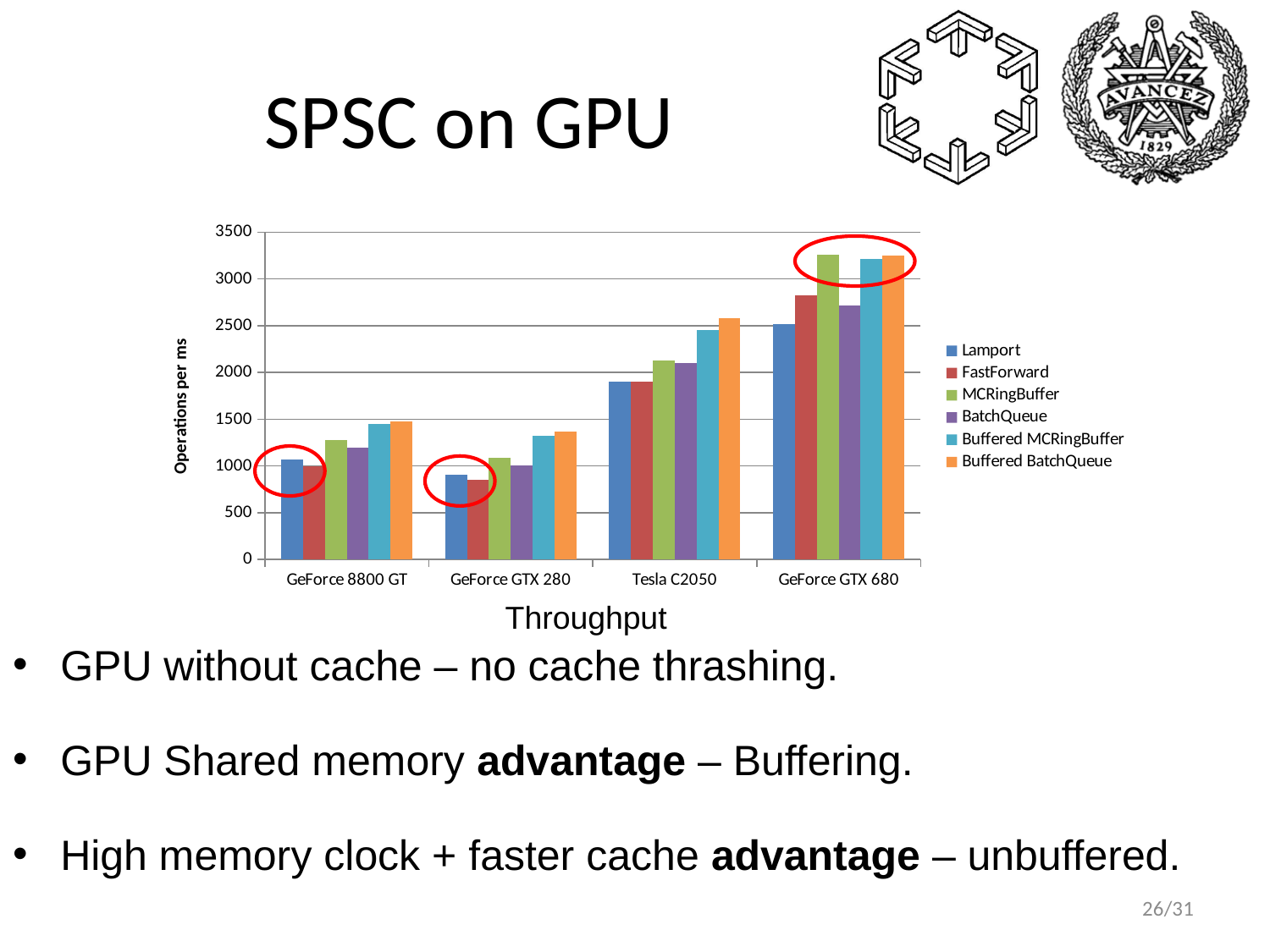
Is the value for Lamport on Tesla C2050 greater or less than 2000? less What kind of chart is shown on the slide? bar chart How many GPU categories are shown on the x axis of the chart? 4 How many series does the chart's legend list? 6 What is the label on the chart's vertical axis? Operations per ms For GeForce GTX 680, which is larger: Lamport or MCRingBuffer? MCRingBuffer Is the value for BatchQueue on GeForce GTX 680 greater or less than 3000? less Is the value for FastForward on GeForce GTX 280 greater or less than 1000? less Which GPU has the lowest Buffered BatchQueue value? GeForce GTX 280 Which GPU has the highest Lamport value? GeForce GTX 680 Does the Lamport value rise or fall from Tesla C2050 to GeForce GTX 680? rise